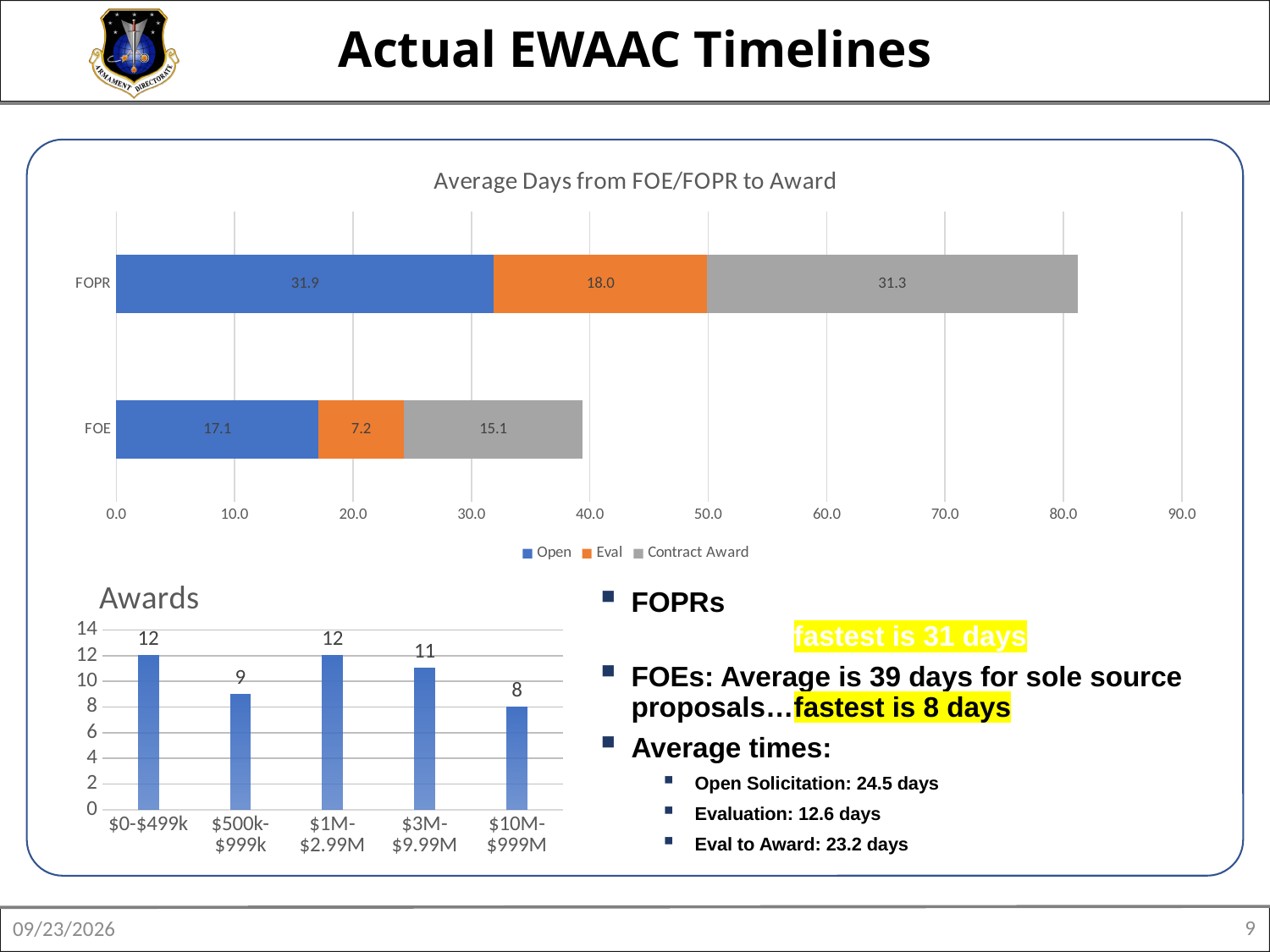
In the 'Average Days from FOE/FOPR to Award' chart, what is the Open value for FOPR? 31.9 In the 'Average Days from FOE/FOPR to Award' chart, what is the Contract Award value for FOPR? 31.3 In the 'Average Days from FOE/FOPR to Award' chart, how many series does the legend list? 3 What kind of chart is the 'Awards' chart? Bar chart In the 'Awards' chart, how many categories are shown? 5 In the 'Average Days from FOE/FOPR to Award' chart, what is the Eval value for FOE? 7.2 In the 'Awards' chart, what is the difference between the values for $3M-$9.99M and $10M-$999M? 3 In the 'Average Days from FOE/FOPR to Award' chart, what is the total of the FOE stacked bar? 39.4 In the 'Awards' chart, what is the value for $500k-$999k? 9 In the 'Average Days from FOE/FOPR to Award' chart, what is the difference between the Open values for FOPR and FOE? 14.8 In the 'Average Days from FOE/FOPR to Award' chart, what is the total of the FOPR stacked bar? 81.2 In the 'Awards' chart, which category has the lowest value? $10M-$999M